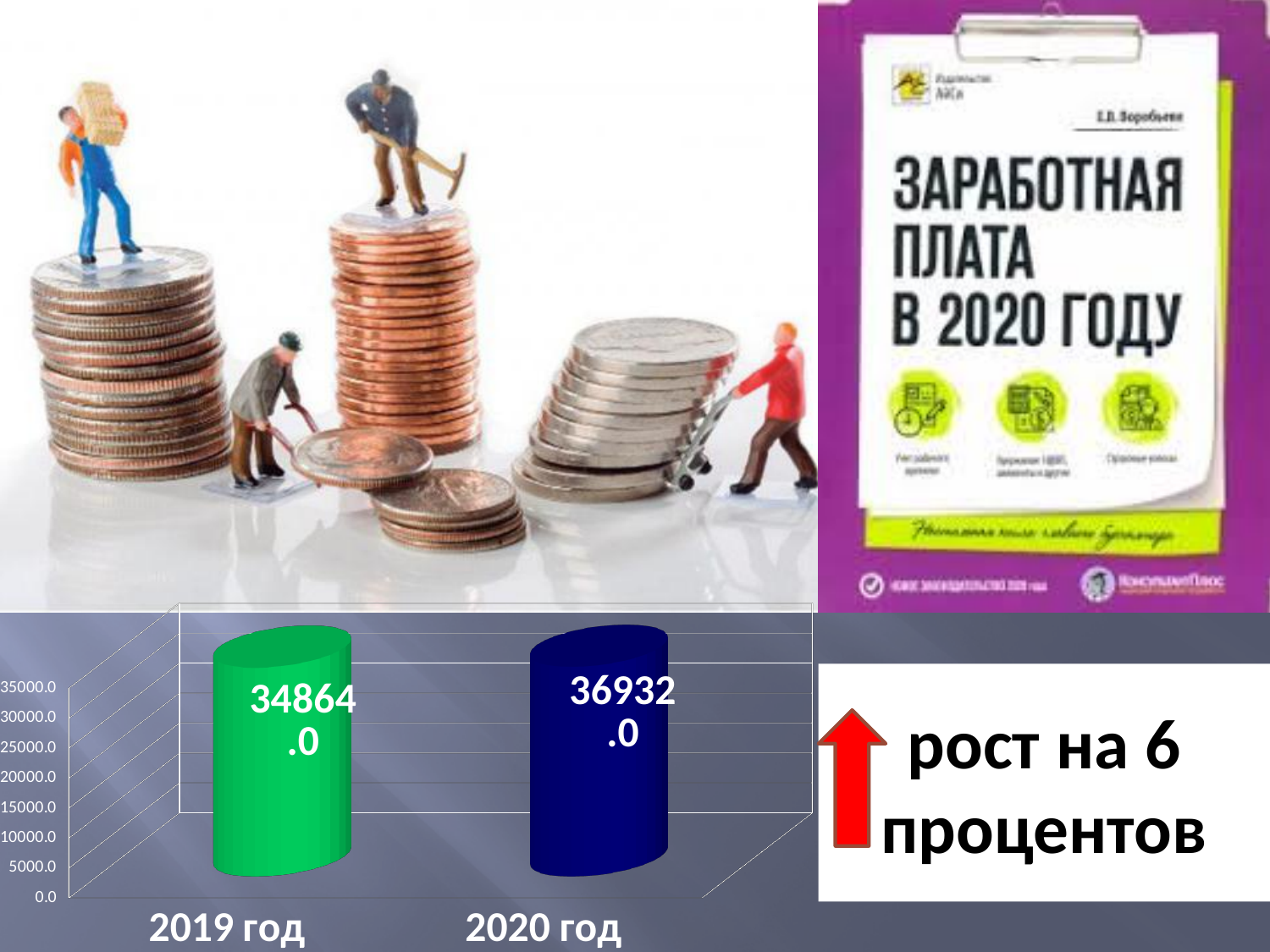
What colour is the bar for 2019 год? green What is the difference between the values for 2020 год and 2019 год? 2068.0 What is the value shown for 2019 год? 34864.0 What is the value shown for 2020 год? 36932.0 Which year has the lower value in the chart? 2019 год Is the value for 2020 год greater or less than 35000.0? greater Do the values rise or fall from 2019 год to 2020 год? rise Which year has the higher value in the chart? 2020 год Is the value for 2020 год larger or smaller than the value for 2019 год? larger How many categories are shown in the chart? 2 What kind of chart is shown on the slide? bar chart Is the value for 2019 год greater or less than 30000.0? greater